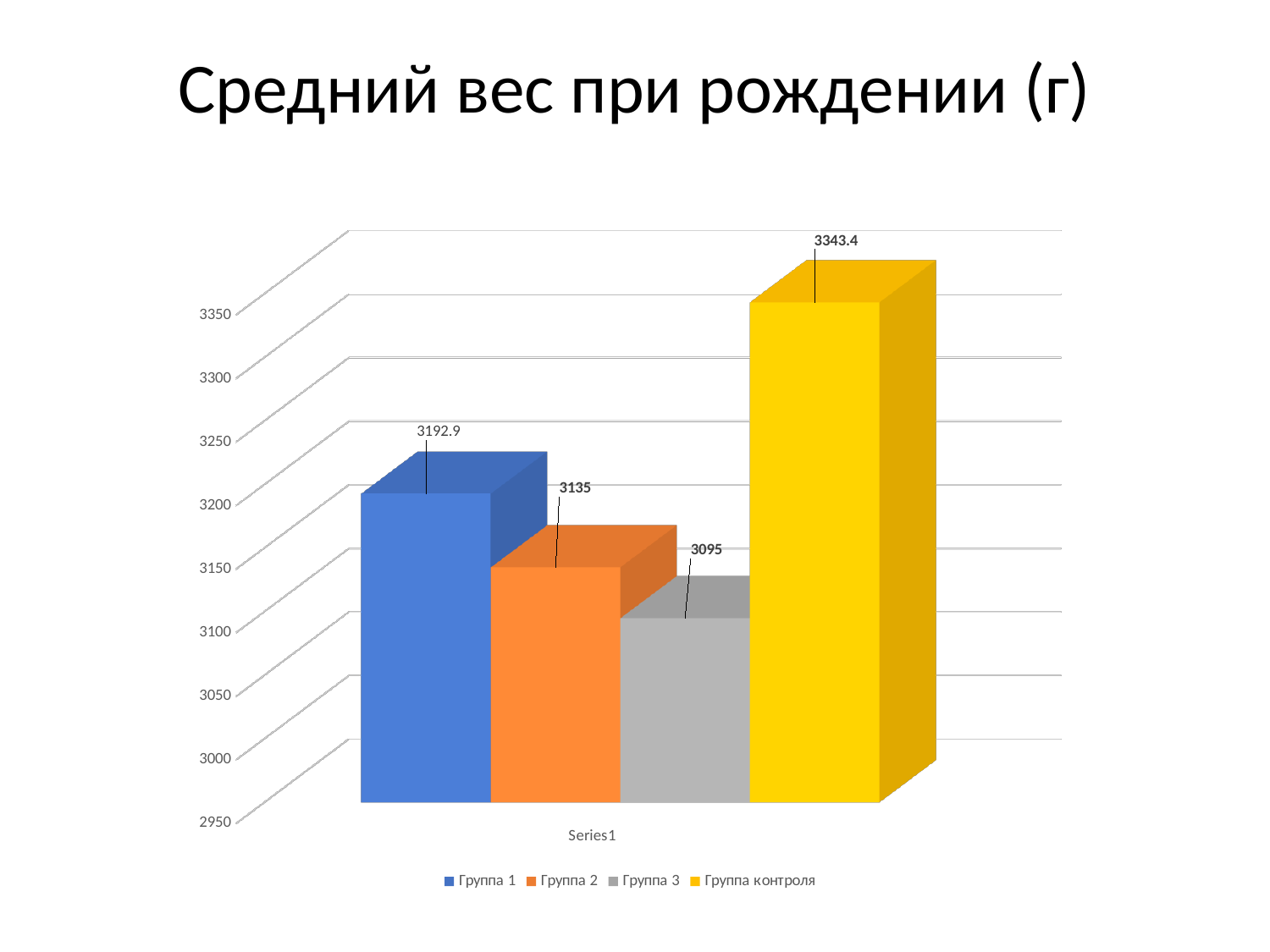
How many series does the legend list? 4 Which group has the highest value? Группа контроля What is the value for Группа 1? 3192.9 What is the difference between the values for Группа 2 and Группа 3? 40 Which group has the lowest value? Группа 3 Which is larger, the value for Группа 1 or the value for Группа 2? Группа 1 What is the value for Группа 2? 3135 What is the value for Группа 3? 3095 What is the value for Группа контроля? 3343.4 What is the difference between the values for Группа контроля and Группа 1? 150.5 What kind of chart is shown on the slide? Bar chart What is the title of the chart? Средний вес при рождении (г)